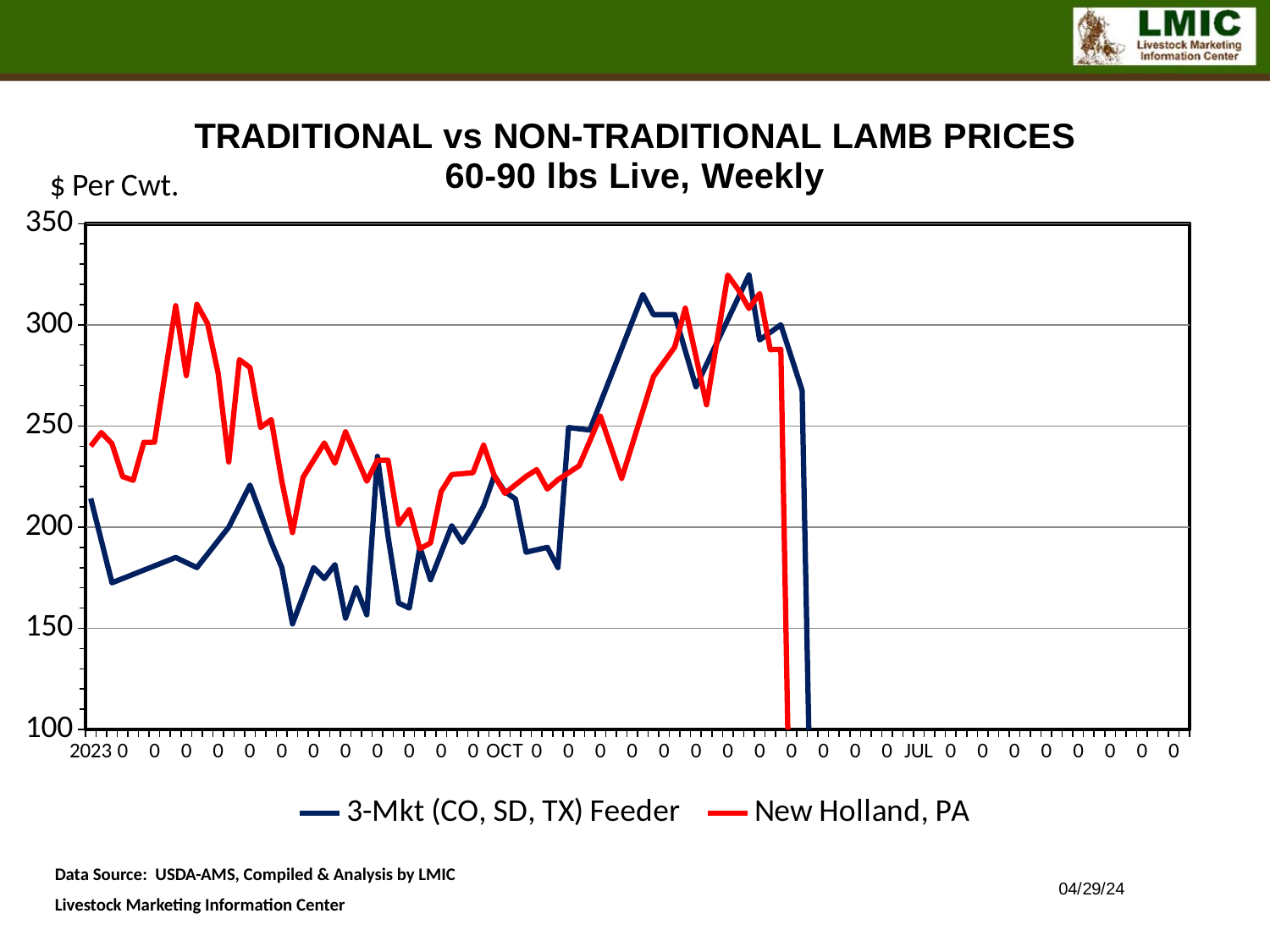
What is the highest value shown on the vertical axis? 350 Is the lowest point of the 3-Mkt (CO, SD, TX) Feeder series greater or less than 200? less Is the highest point of the 3-Mkt (CO, SD, TX) Feeder series greater or less than 300? greater Is the highest point of the New Holland, PA series greater or less than 300? greater What are the two series named in the legend? 3-Mkt (CO, SD, TX) Feeder and New Holland, PA How many series does the legend list? 2 At the 2023 label on the x axis, which series has the higher value, 3-Mkt (CO, SD, TX) Feeder or New Holland, PA? New Holland, PA What unit is shown on the vertical axis label? $ Per Cwt. From the OCT label to its peak shortly before the lines end, does the 3-Mkt (CO, SD, TX) Feeder series rise or fall? rise What kind of chart is shown on the slide? line chart